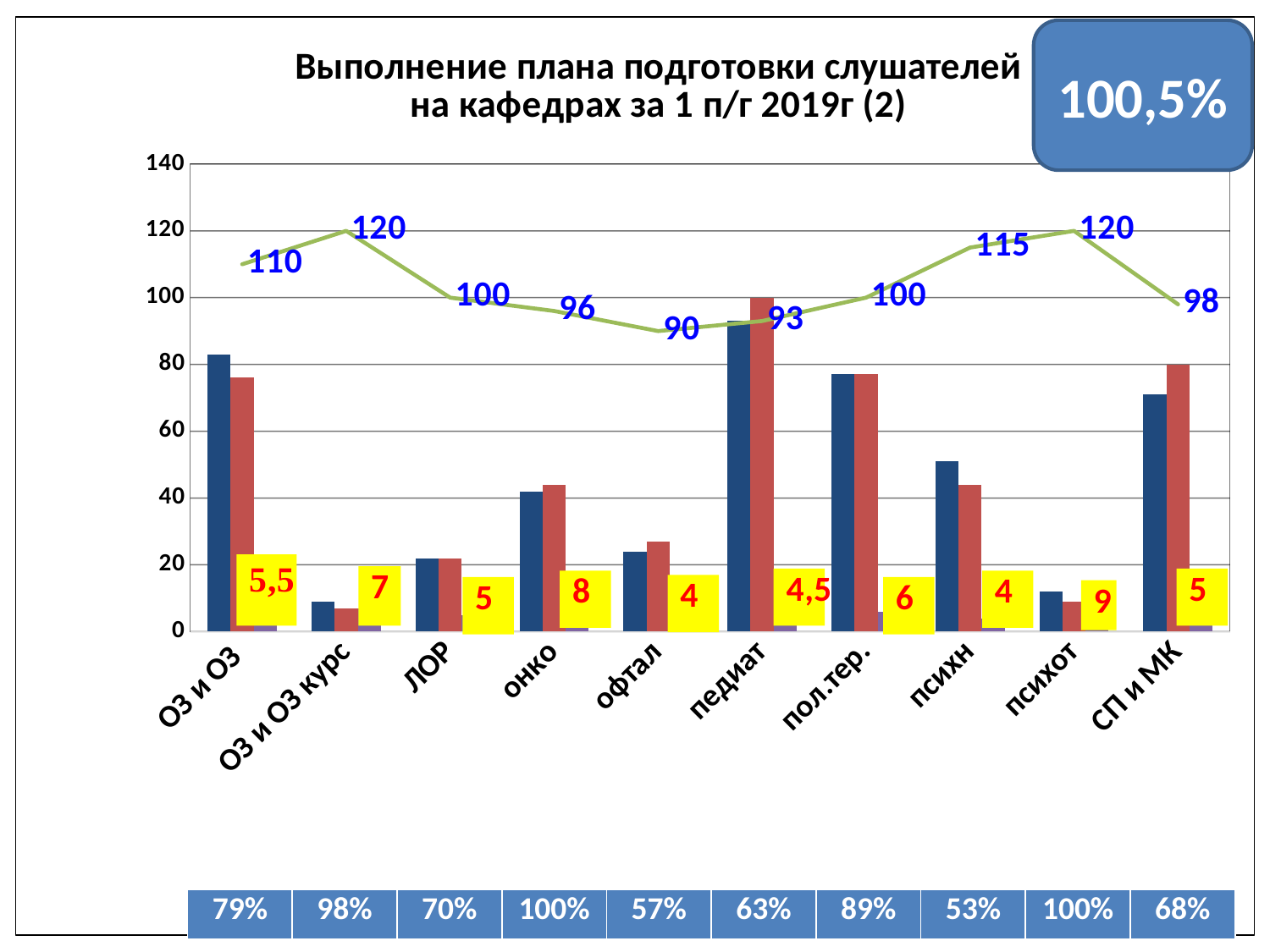
What kind of chart is this? Bar chart with a line What is the difference between the green line values at ОЗ и ОЗ курс and ОЗ и ОЗ? 10 What is the value of the green line at психн? 115 Which has a higher green line value, психн or пол.тер.? психн What number is shown in the yellow box for психот? 9 At which category does the green line reach its lowest value? офтал Does the green line rise or fall from пол.тер. to психот? Rise Is the value of the blue bar for педиат greater or less than 80? greater What is the value of the green line at СП и МК? 98 How many categories are shown on the x axis? 10 What is the value of the green line at офтал? 90 Is the value of the red bar for ЛОР greater or less than 40? less